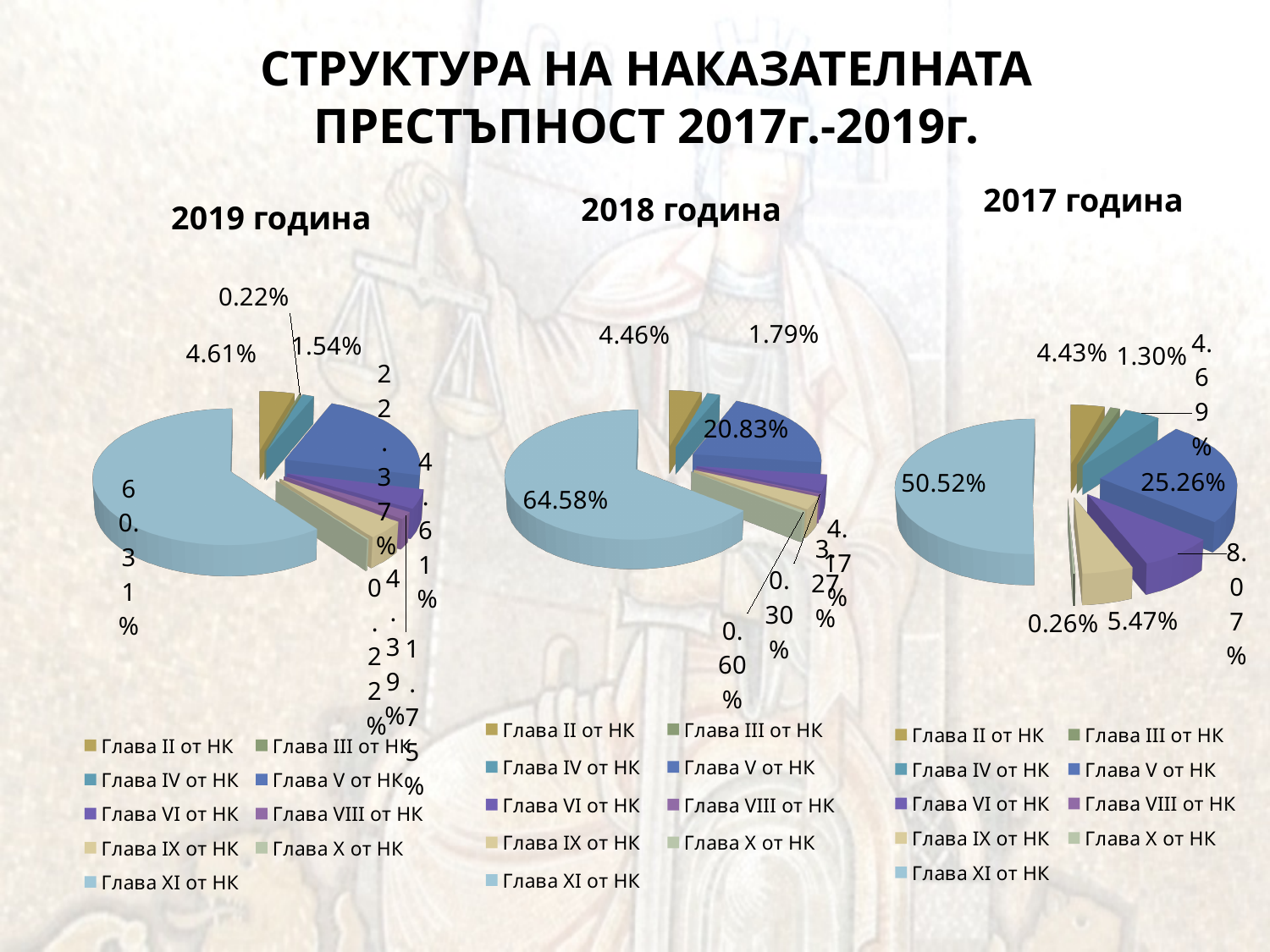
Is the share of Глава XI от НК larger in the 2018 година chart or in the 2017 година chart? 2018 година Which legend entry corresponds to the largest (light blue) slice in each chart? Глава XI от НК In the 2018 година chart, what is the value of the largest slice? 64.58% What is the difference between the largest slice in the 2018 година chart (64.58%) and the largest slice in the 2017 година chart (50.52%)? 14.06 percentage points In the 2017 година chart, what share is shown for Глава V от НК (the dark blue slice)? 25.26% How many pie charts are shown on the slide? 3 In the 2019 година chart, what is the value of the largest slice? 60.31% How many entries does the legend of the 2019 година chart list? 9 What kind of chart is used for each of the three years on the slide? Pie chart In the 2018 година chart, what share is shown for Глава V от НК (the dark blue slice)? 20.83% In the 2017 година chart, what is the value of the largest slice? 50.52% In the 2017 година chart, what share is shown for Глава VI от НК (the purple slice)? 8.07%